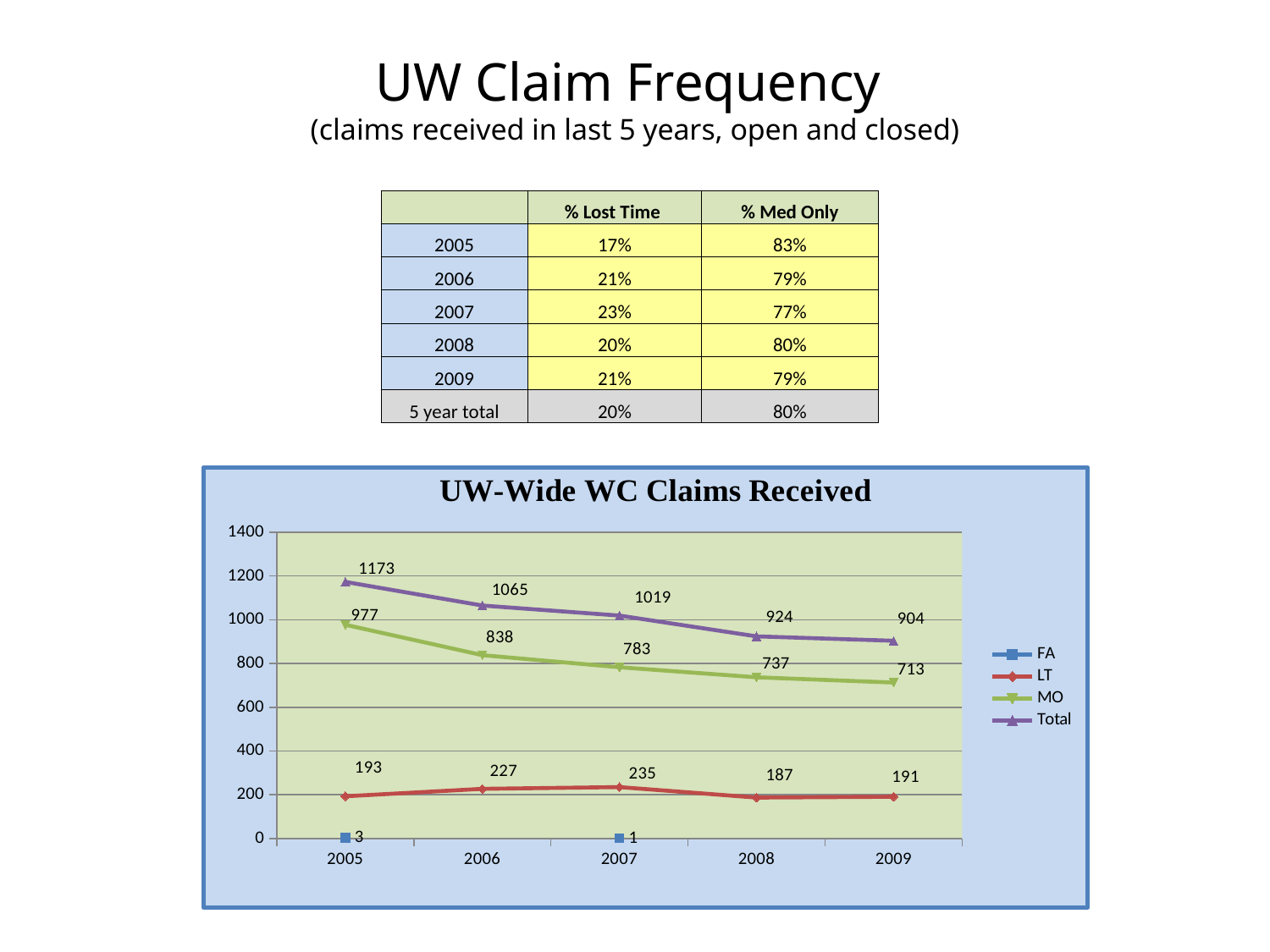
In the "UW-Wide WC Claims Received" chart, which year has the lowest Total value? 2009 What kind of chart is "UW-Wide WC Claims Received"? Line chart In the "UW-Wide WC Claims Received" chart, does the Total series rise or fall from 2005 to 2009? Fall In the "UW-Wide WC Claims Received" chart, what is the FA value for 2005? 3 In the "UW-Wide WC Claims Received" chart, what is the MO value for 2008? 737 In the "UW-Wide WC Claims Received" chart, which year has the highest LT value? 2007 In the "UW-Wide WC Claims Received" chart, what is the Total value for 2005? 1173 In the "UW-Wide WC Claims Received" chart, which is larger: the MO value for 2006 or the MO value for 2007? 2006 In the "UW-Wide WC Claims Received" chart, how many series does the legend list? 4 In the "UW-Wide WC Claims Received" chart, how many years are shown on the x axis? 5 In the "UW-Wide WC Claims Received" chart, what is the difference between the Total values for 2005 and 2009? 269 In the "UW-Wide WC Claims Received" chart, what is the LT value for 2007? 235